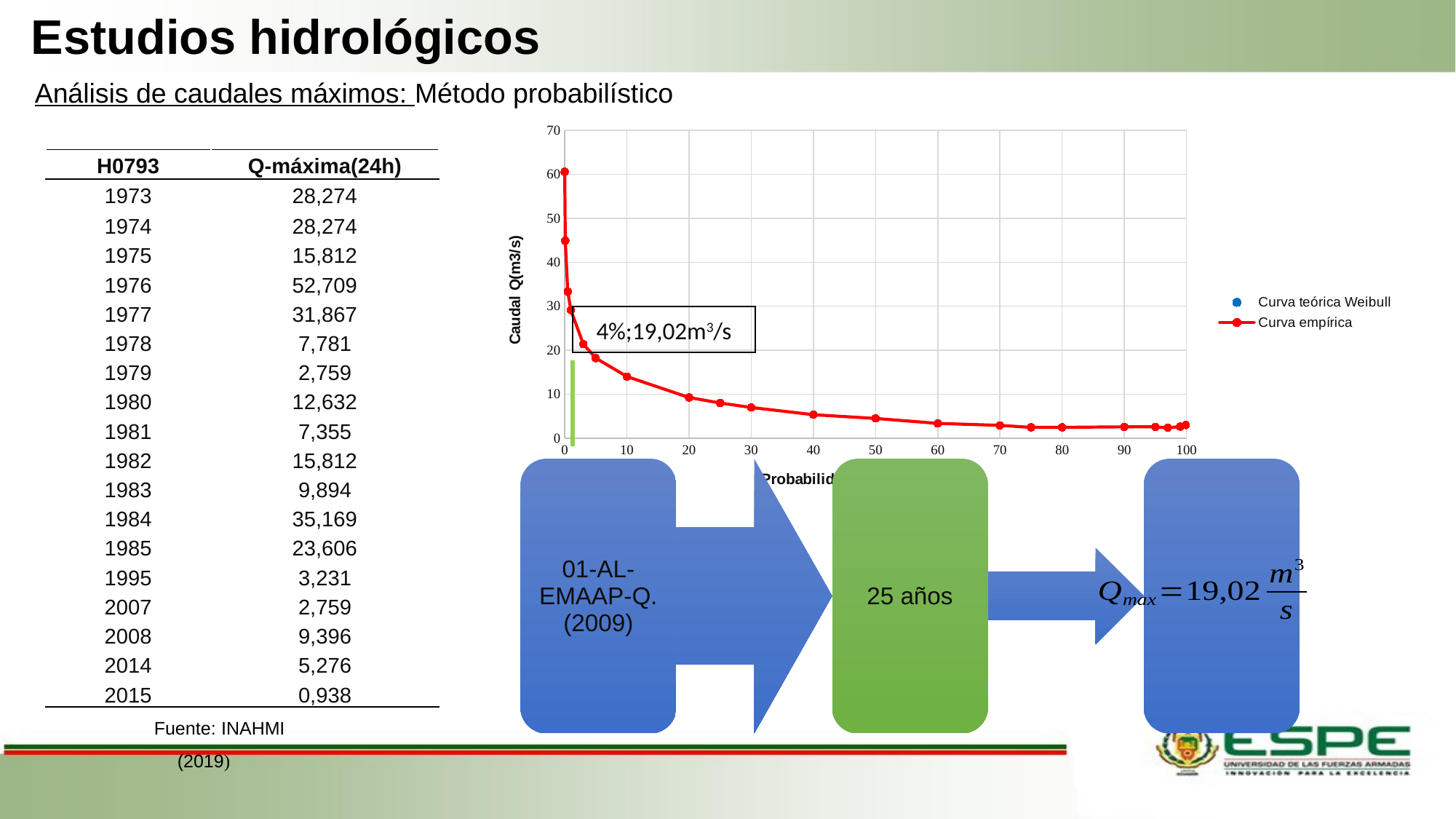
How many series does the chart legend list? 2 What are the two series named in the chart legend? Curva teórica Weibull and Curva empírica Is the value of the Curva empírica at probability 10 greater or less than 20? less What kind of chart is shown on the slide? line chart Is the value of the Curva empírica at probability 10 greater or less than 10? greater According to the annotation on the chart, what is the caudal value at 4% probability? 19,02m³/s Is the value of the Curva empírica at probability 100 greater or less than 10? less What is the label of the chart's y axis? Caudal Q(m3/s) Do the values of the Curva empírica rise or fall as probability increases along the x axis? fall Which has the larger caudal value on the Curva empírica: probability 10 or probability 60? probability 10